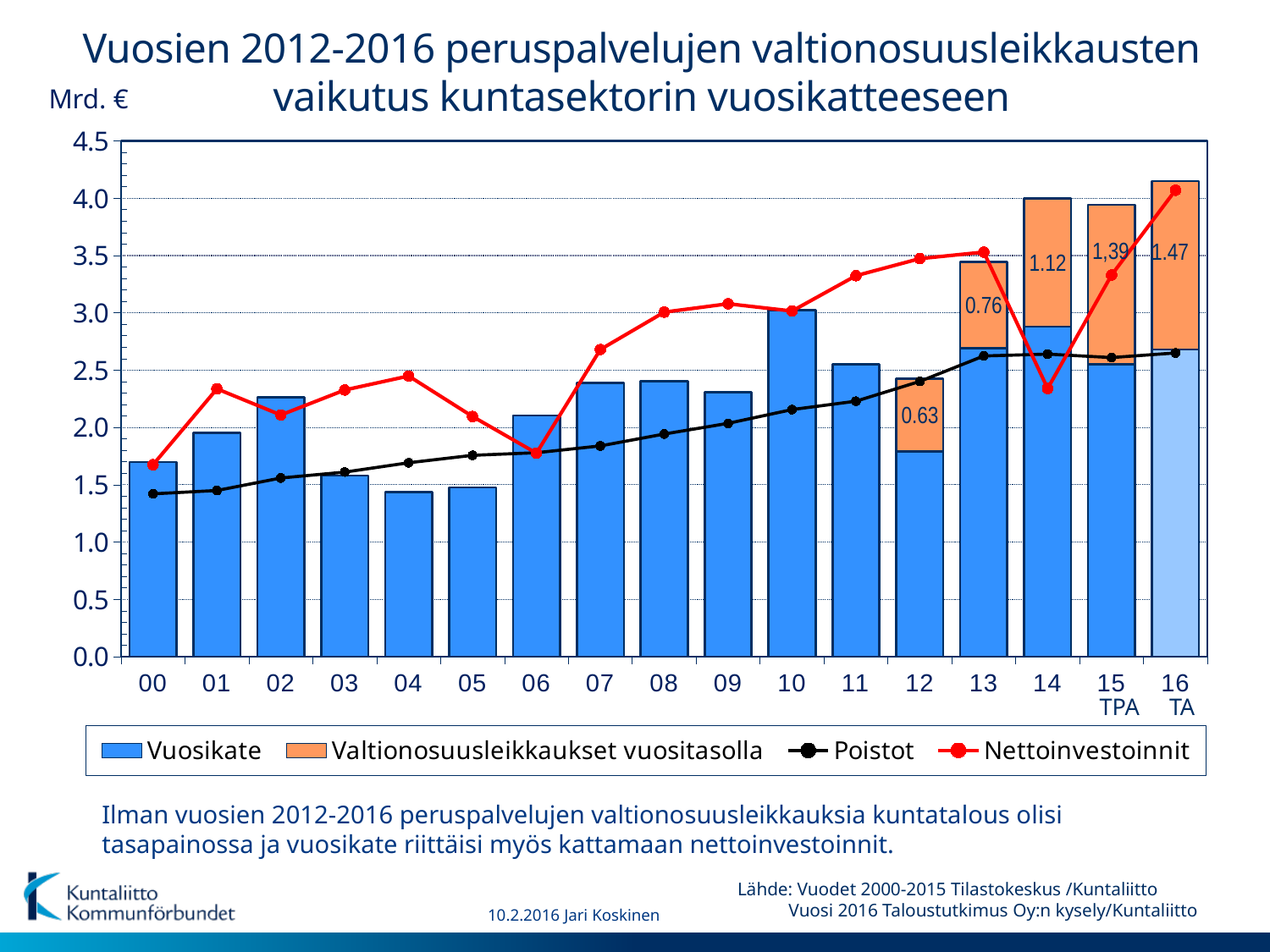
What is the value of Valtionosuusleikkaukset vuositasolla for 14? 1.12 What kind of chart is shown on the slide? A bar chart combined with line series In which year is the labelled Valtionosuusleikkaukset vuositasolla value the highest? 16 TA How many years (categories) are shown on the x axis? 17 What is the value of Valtionosuusleikkaukset vuositasolla for 12? 0.63 Does the Poistot line generally rise or fall from 00 to 16 TA? rise Is the Vuosikate value for 10 greater or less than 2.5? greater In which year is the labelled Valtionosuusleikkaukset vuositasolla value the lowest? 12 How many series does the legend list? 4 Which is larger in 10, Nettoinvestoinnit or Poistot? Nettoinvestoinnit What is the difference between the Valtionosuusleikkaukset vuositasolla values for 16 TA and 12? 0.84 What is the value of Valtionosuusleikkaukset vuositasolla for 16 TA? 1.47